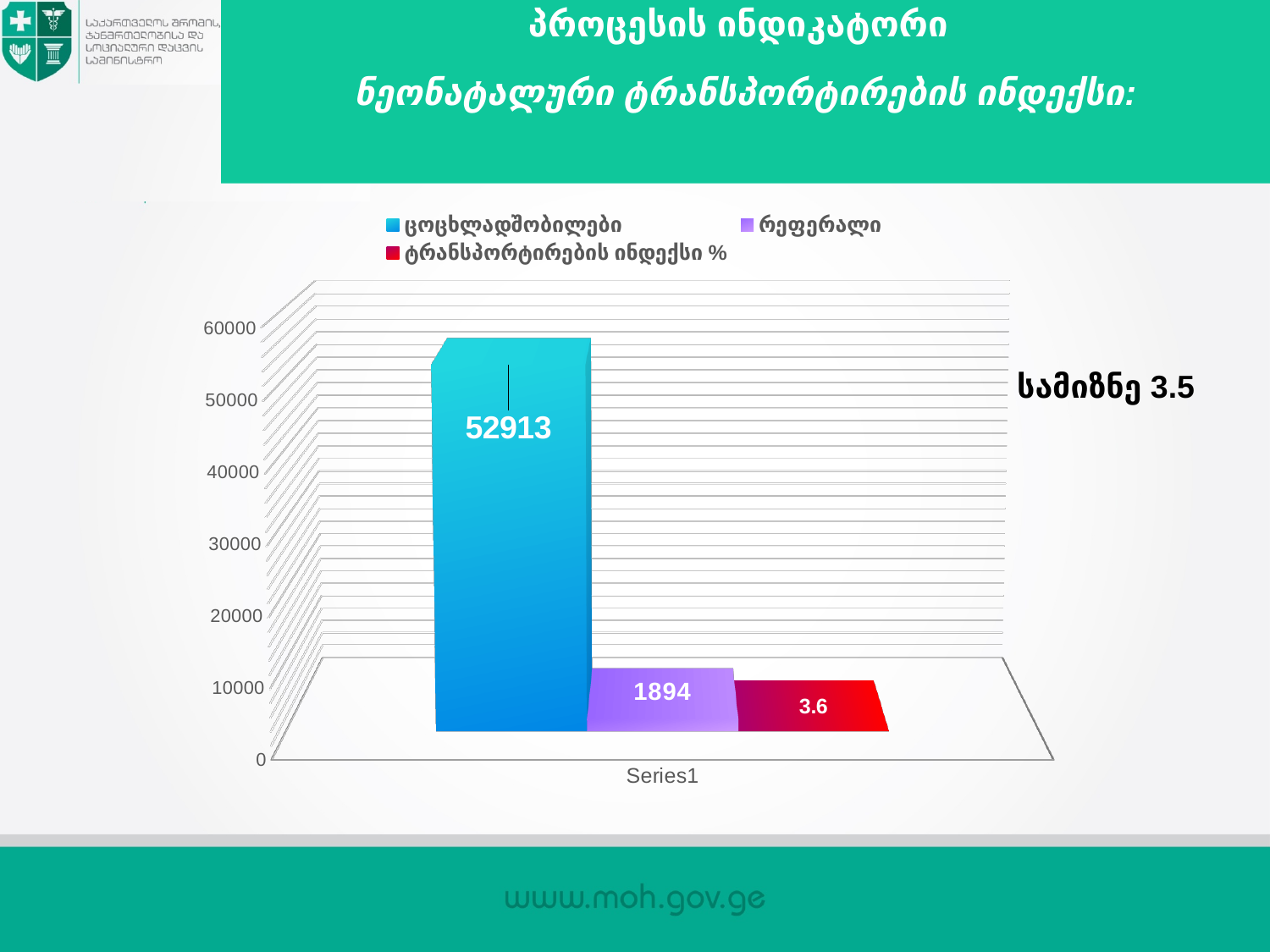
Which series has the lowest value? ტრანსპორტირების ინდექსი % What is the value of the რეფერალი series? 1894 Which is larger, the რეფერალი value or the ტრანსპორტირების ინდექსი % value? რეფერალი What is the difference between the ცოცხლადშობილები value and the რეფერალი value? 51019 What is the value of the ტრანსპორტირების ინდექსი % series? 3.6 What kind of chart is shown on the slide? bar chart Is the value for ცოცხლადშობილები greater or less than 50000? greater What is the value of the ცოცხლადშობილები series? 52913 Which series has the highest value? ცოცხლადშობილები How many series does the legend list? 3 What target value (სამიზნე) is written next to the chart? 3.5 What is the category label shown on the x axis? Series1